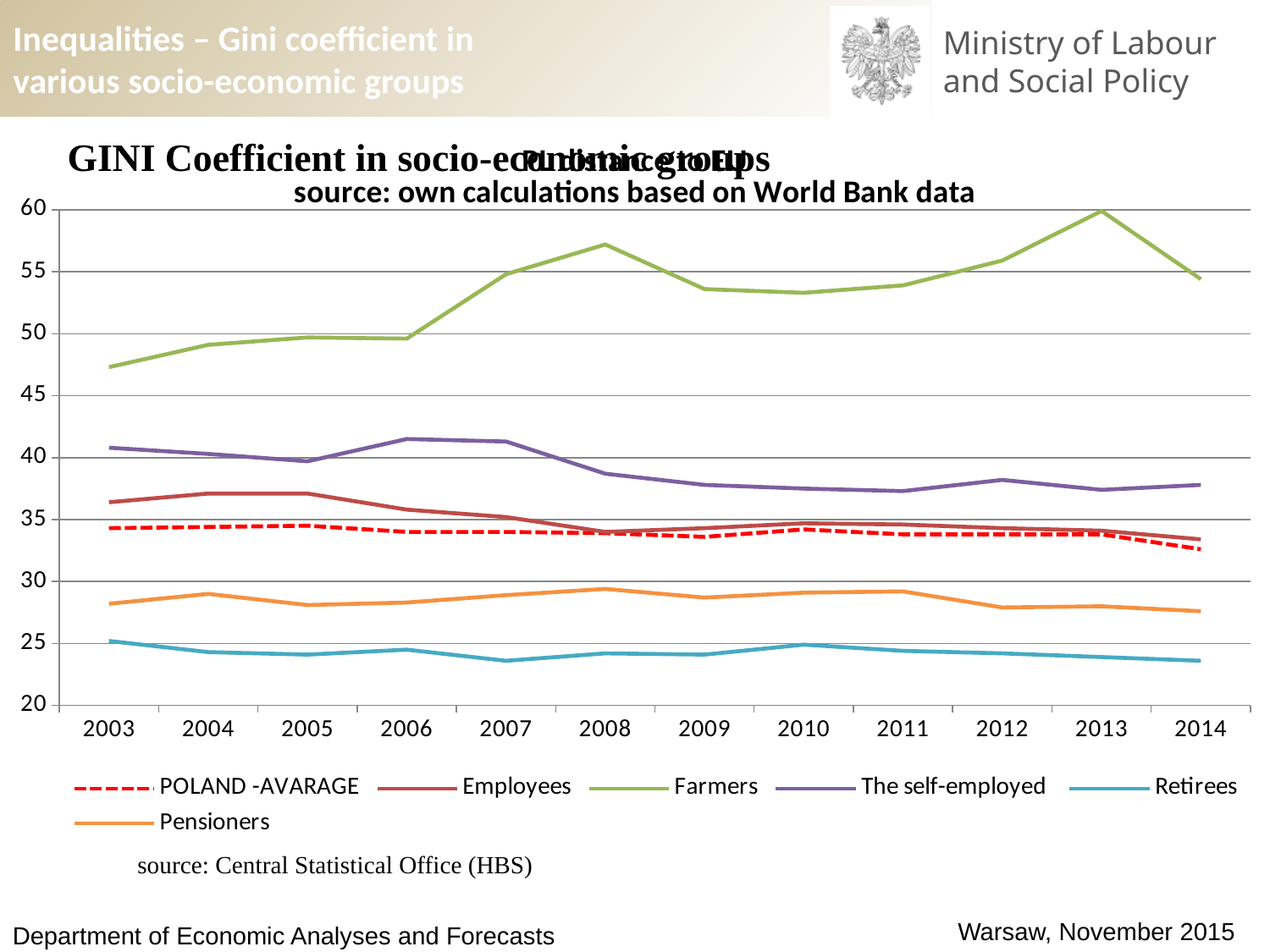
Which group has the lowest Gini coefficient across the whole period? Retirees Is the value for The self-employed in 2006 greater or less than 40? greater What kind of chart is shown on the slide? line chart How many years are plotted along the x axis? 12 In which year does the Farmers line reach its highest value? 2013 Which is larger in 2010, the value for Farmers or the value for The self-employed? Farmers Is the value for Retirees in 2007 greater or less than 25? less Is the value for Farmers in 2013 greater or less than 55? greater Does the Farmers line generally rise or fall from 2003 to 2013? rise How many series does the chart legend list? 6 Which group has the highest Gini coefficient in 2014? Farmers